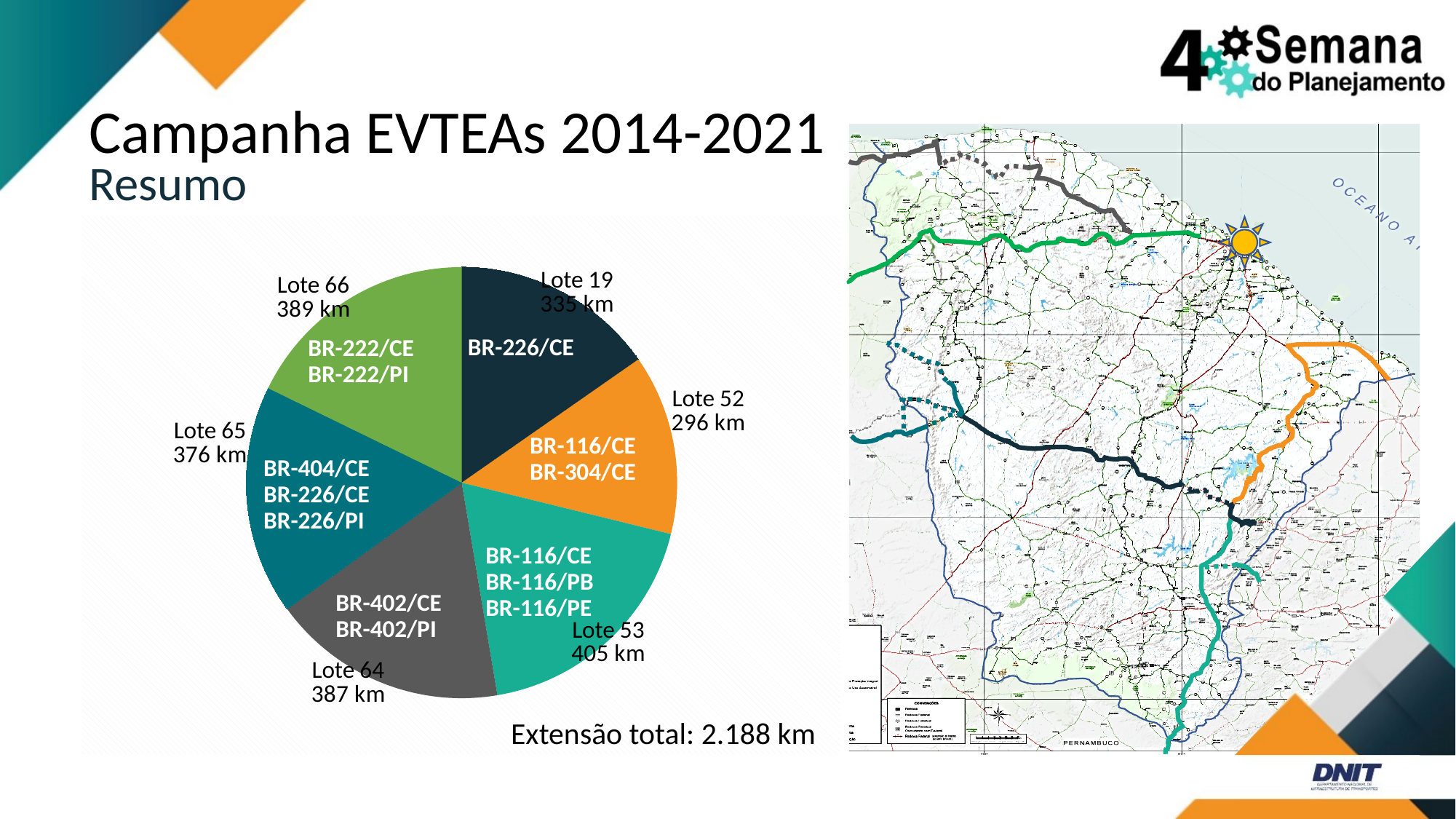
What is the extension in km for Lote 64? 387 km What is the total extension shown below the pie chart? 2.188 km What kind of chart is shown on the slide? pie chart Which road is labelled inside the Lote 19 slice of the pie chart? BR-226/CE Which has a larger extension, Lote 66 or Lote 19? Lote 66 Which lote has the largest extension in the pie chart? Lote 53 How many slices (lotes) does the pie chart have? 6 Which lote has the smallest extension in the pie chart? Lote 52 What is the difference in km between Lote 53 and Lote 52? 109 km What is the extension in km for Lote 65? 376 km What is the extension in km for Lote 19? 335 km What is the extension in km for Lote 52? 296 km